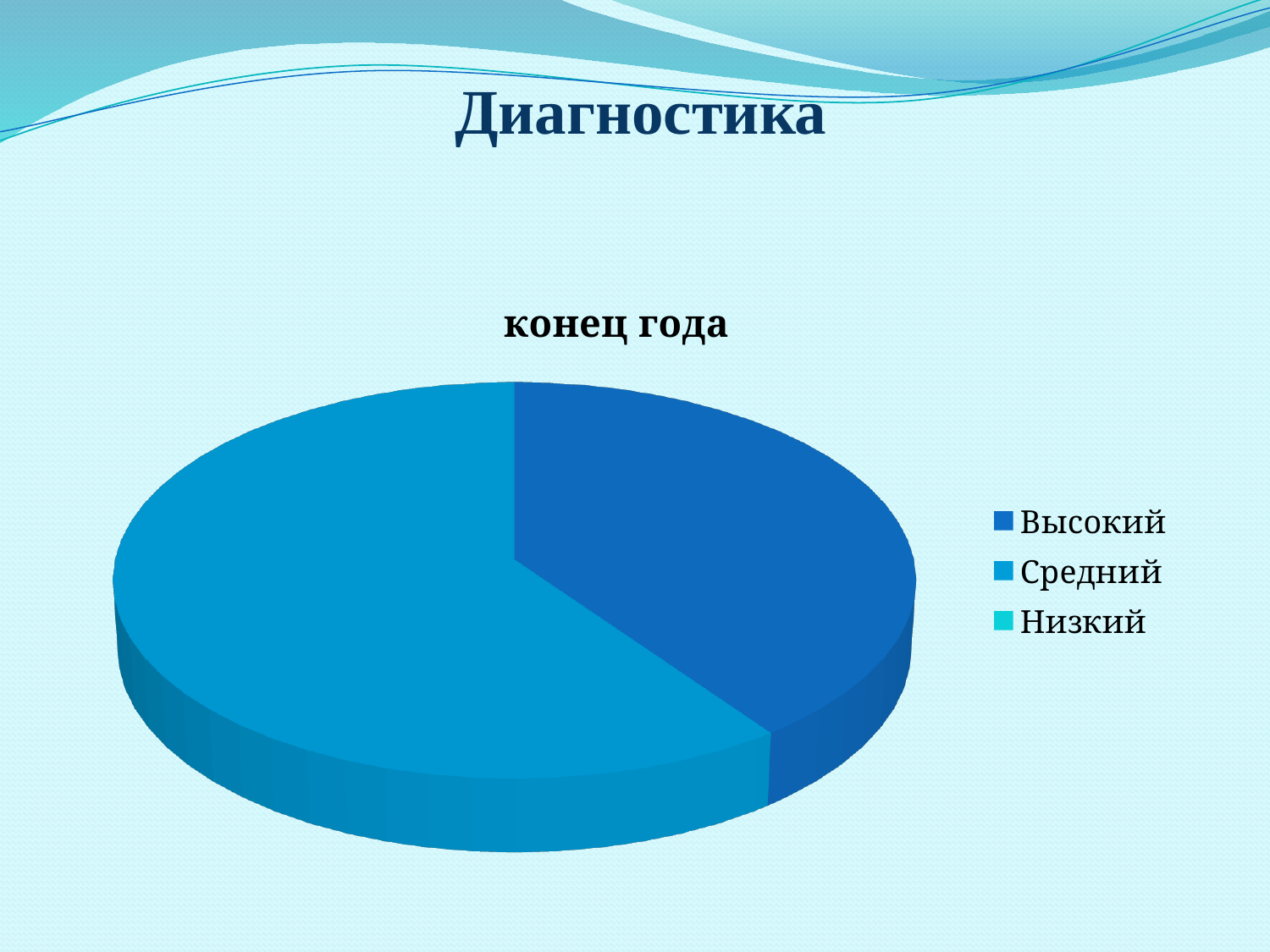
Which slice is larger, Высокий or Низкий? Высокий Which category has the smallest share of the pie? Низкий Which category has the largest slice of the pie? Средний Which slice is larger, Высокий or Средний? Средний What is the title of the chart? конец года What kind of chart is shown on the slide? pie chart How many entries does the chart legend list? 3 Which legend entry is shown in the darkest blue colour? Высокий Does the Средний slice take up more or less than half of the pie? more